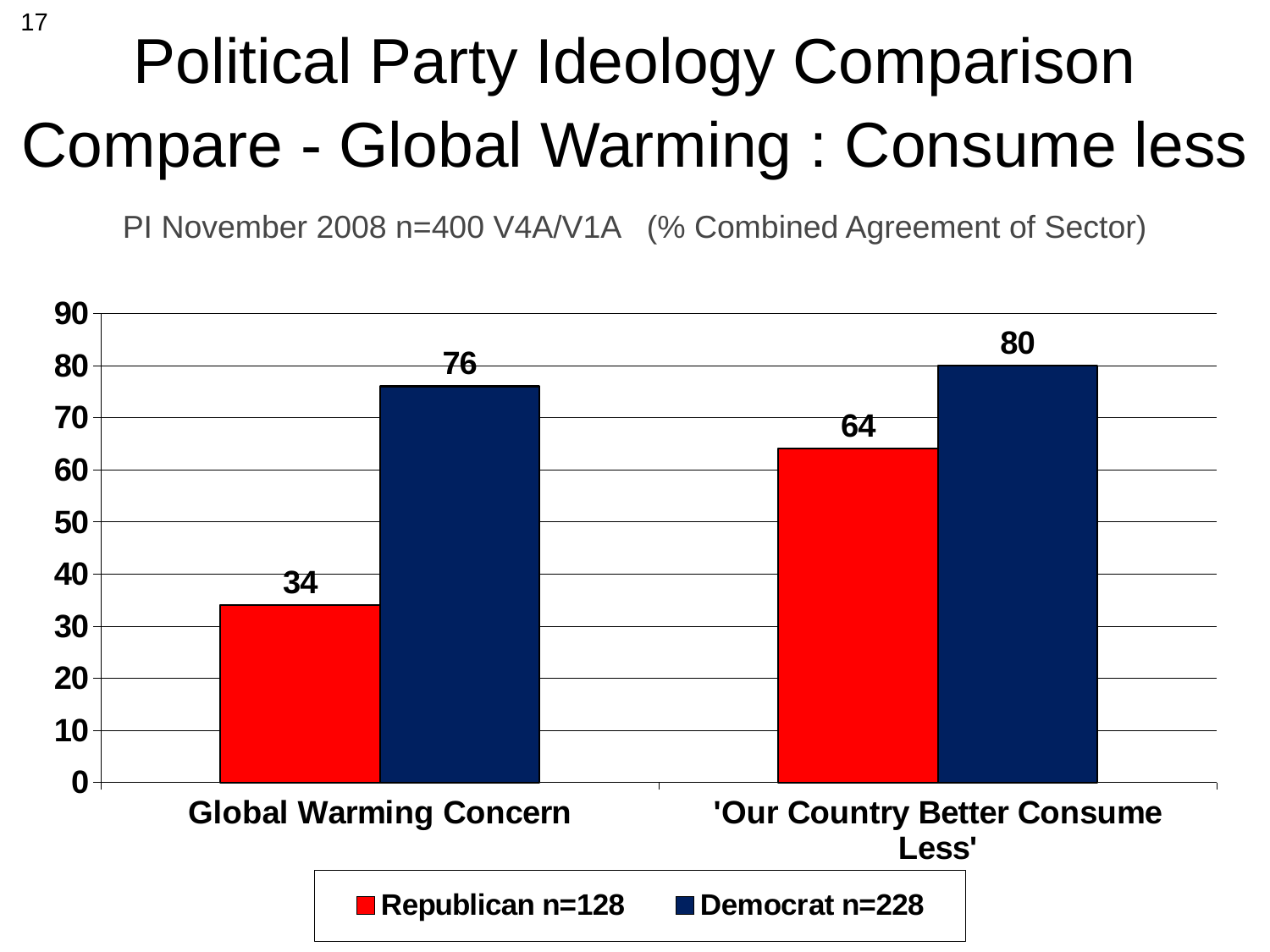
What is the value for Democrat n=228 on 'Our Country Better Consume Less'? 80 What is the value for Democrat n=228 on Global Warming Concern? 76 Which is larger for Global Warming Concern: Republican n=128 or Democrat n=228? Democrat n=228 How many categories are shown on the x axis? 2 What is the difference between the Democrat and Republican values for 'Our Country Better Consume Less'? 16 Which bar has the highest value on the chart? Democrat n=228 on 'Our Country Better Consume Less' What kind of chart is shown on the slide? Bar chart What is the value for Republican n=128 on Global Warming Concern? 34 How many series does the legend list? 2 What is the difference between the Democrat and Republican values for Global Warming Concern? 42 What is the value for Republican n=128 on 'Our Country Better Consume Less'? 64 Which bar has the lowest value on the chart? Republican n=128 on Global Warming Concern